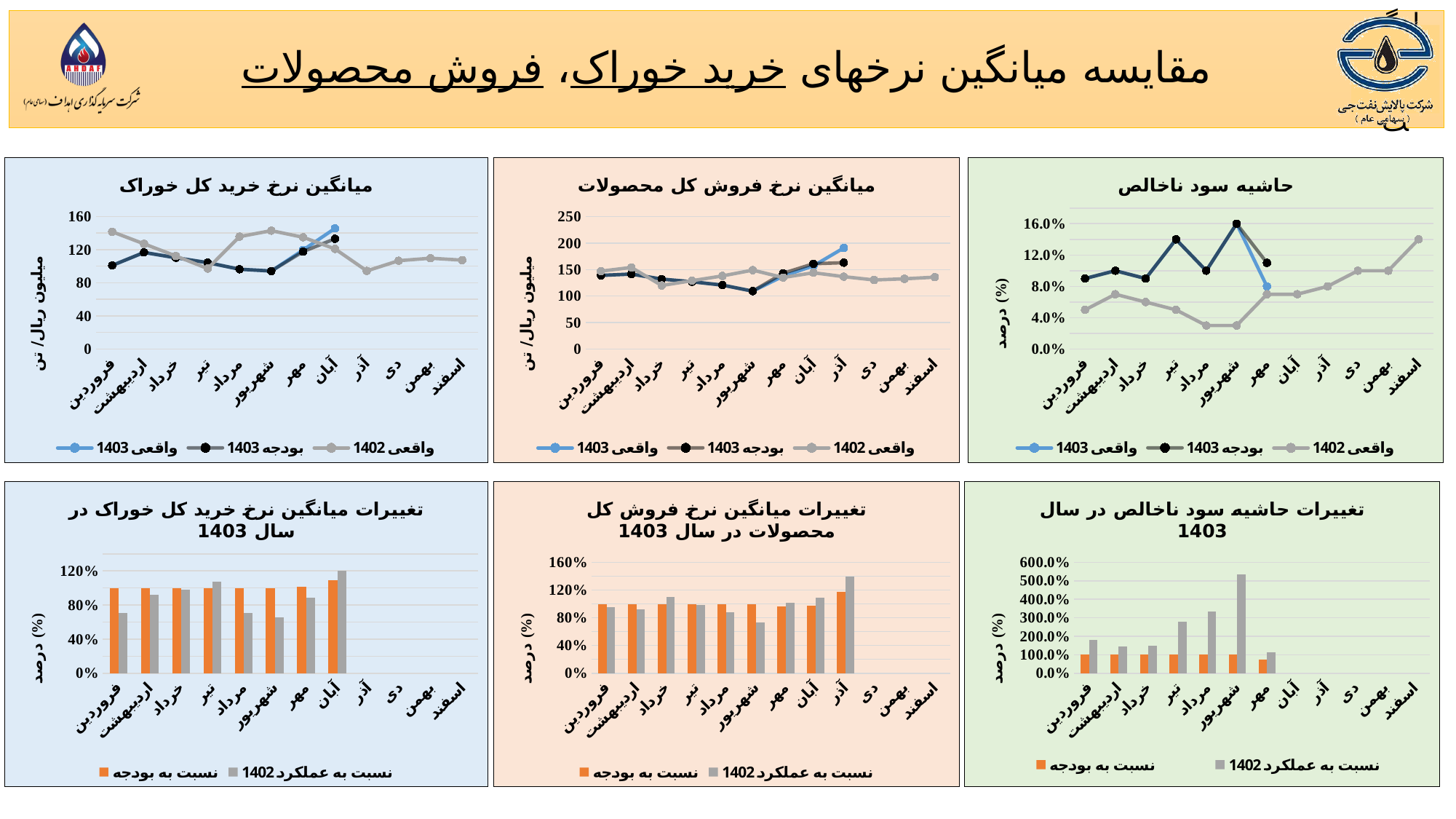
In the top-middle chart titled "میانگین نرخ فروش کل محصولات", is the value of "بودجه 1403" for شهریور greater or less than 150? less How many month categories are shown on the x axis of the top-right chart titled "حاشیه سود ناخالص"? 12 In the top-right chart titled "حاشیه سود ناخالص", is the value of "واقعی 1402" for مرداد greater or less than 4.0%? less In the bottom-middle chart titled "تغییرات میانگین نرخ فروش کل محصولات در سال 1403", is the value of "نسبت به عملکرد 1402" for آذر greater or less than 120%? greater What kind of chart is the top-left chart titled "میانگین نرخ خرید کل خوراک"? line chart In the top-middle chart titled "میانگین نرخ فروش کل محصولات", how many series does the legend list? 3 In the bottom-right chart titled "تغییرات حاشیه سود ناخالص در سال 1403", which month has the highest value for the series "نسبت به عملکرد 1402"? شهریور In the top-right chart titled "حاشیه سود ناخالص", which month has the highest value for the series "بودجه 1403"? شهریور What kind of chart is the bottom-right chart titled "تغییرات حاشیه سود ناخالص در سال 1403"? bar chart In the bottom-left chart titled "تغییرات میانگین نرخ خرید کل خوراک در سال 1403", how many series does the legend list? 2